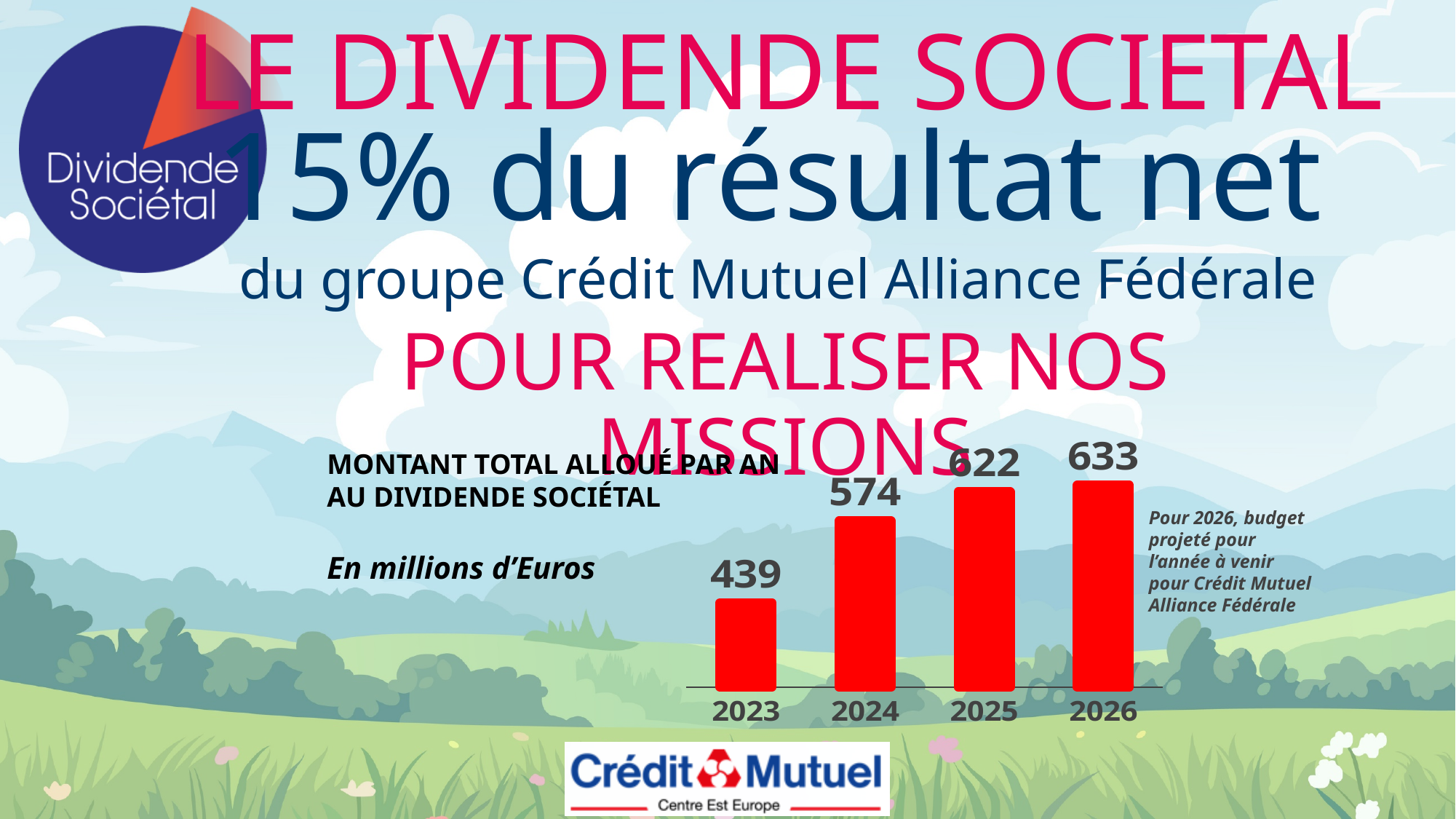
What kind of chart is shown on the slide? bar chart Which year has the lowest value in the bar chart? 2023 What is the value for 2025 in the bar chart? 622 What is the value for 2023 in the bar chart? 439 What is the difference between the values for 2024 and 2023? 135 Do the values rise or fall from 2023 to 2026? rise What is the value for 2026 in the bar chart? 633 Which year has the highest value in the bar chart? 2026 What is the difference between the values for 2026 and 2025? 11 Which is larger, the value for 2024 or the value for 2025? 2025 How many years are shown in the bar chart? 4 What is the value for 2024 in the bar chart? 574